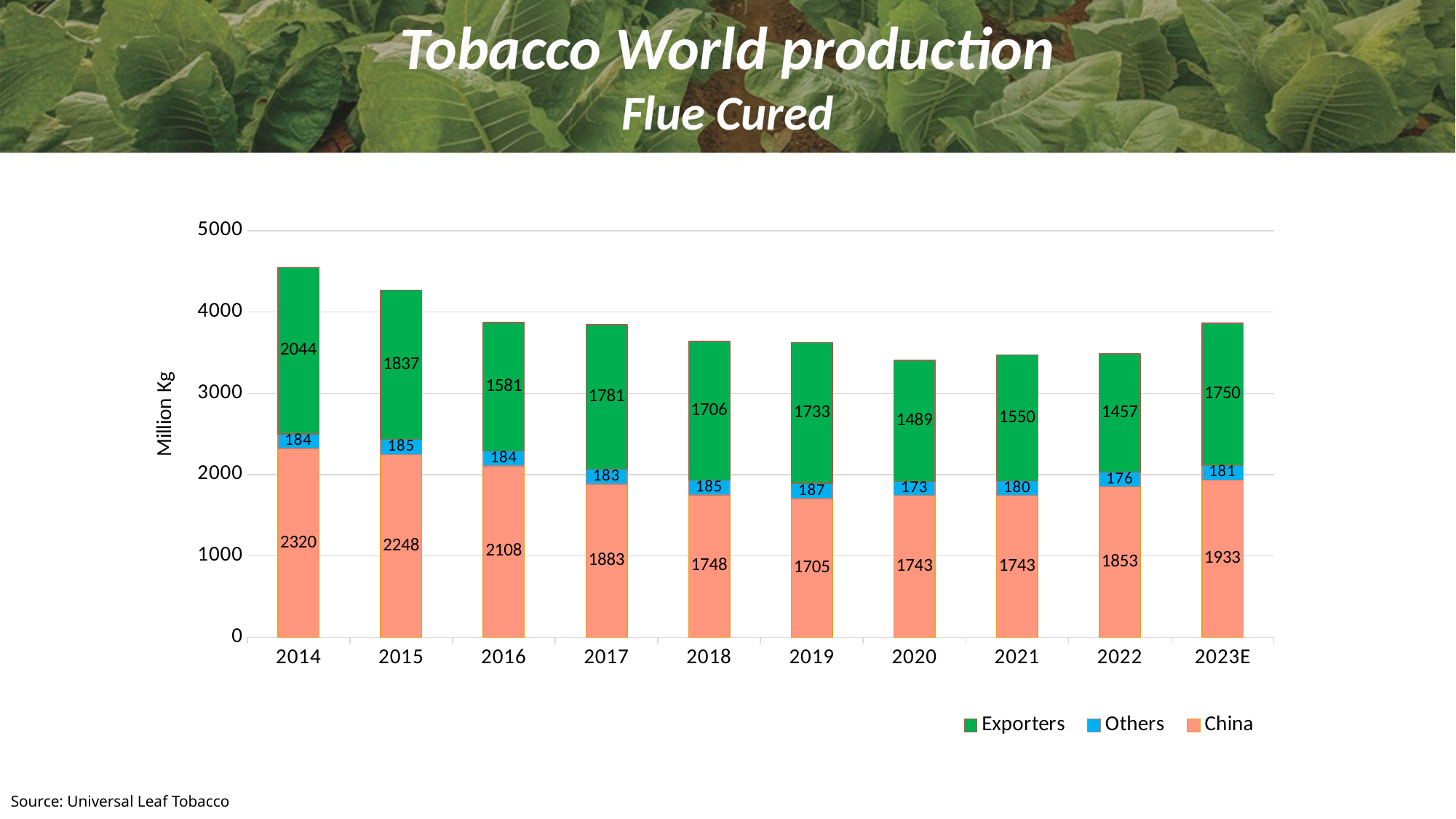
What is the total of the stacked bar for 2020? 3405 What is the Exporters value for 2023E? 1750 How many series does the legend list? 3 What is the China value for 2014? 2320 In which year is the Exporters value the highest? 2014 In which year is the China value the lowest? 2019 How many years are shown on the x axis? 10 What is the difference between the China value in 2014 and in 2023E? 387 What is the Others value for 2020? 173 In which year is the Exporters value the lowest? 2022 What kind of chart is shown on the slide? Stacked bar chart Which is larger, the Exporters value in 2017 or in 2018? 2017